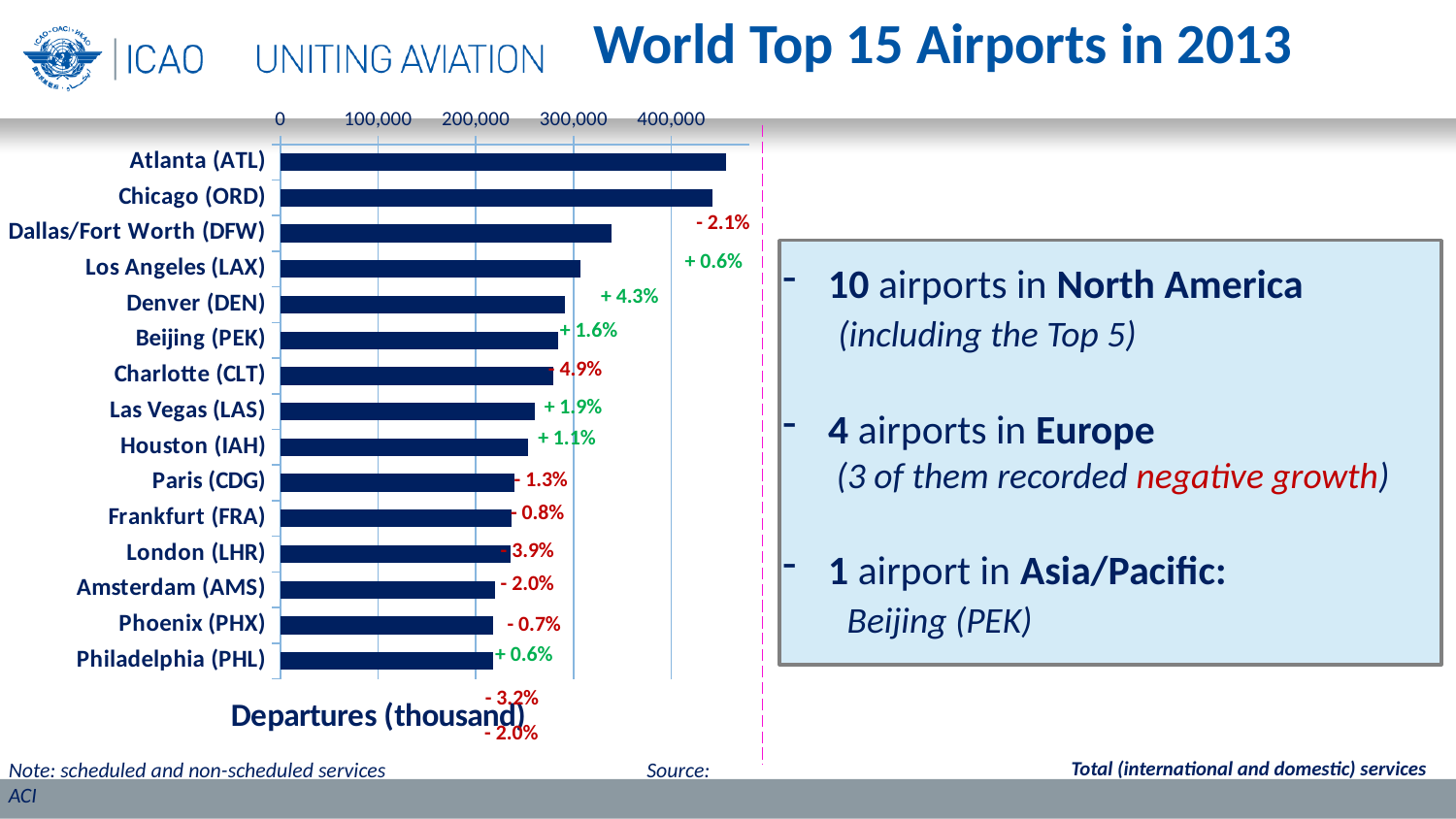
Is the value for Atlanta (ATL) greater or less than 400,000? greater Which has more departures, Atlanta (ATL) or Dallas/Fort Worth (DFW)? Atlanta (ATL) Is the value for Chicago (ORD) greater or less than 400,000? greater Is the value for Paris (CDG) greater or less than 300,000? less How many airports are listed in the chart? 15 Do the bar values rise or fall going down the list from Atlanta (ATL) to Philadelphia (PHL)? fall What is the axis title shown below the bars? Departures (thousand) Which has more departures, Chicago (ORD) or London (LHR)? Chicago (ORD) What kind of chart is shown on the slide? bar chart Which airport has the highest number of departures in the chart? Atlanta (ATL)